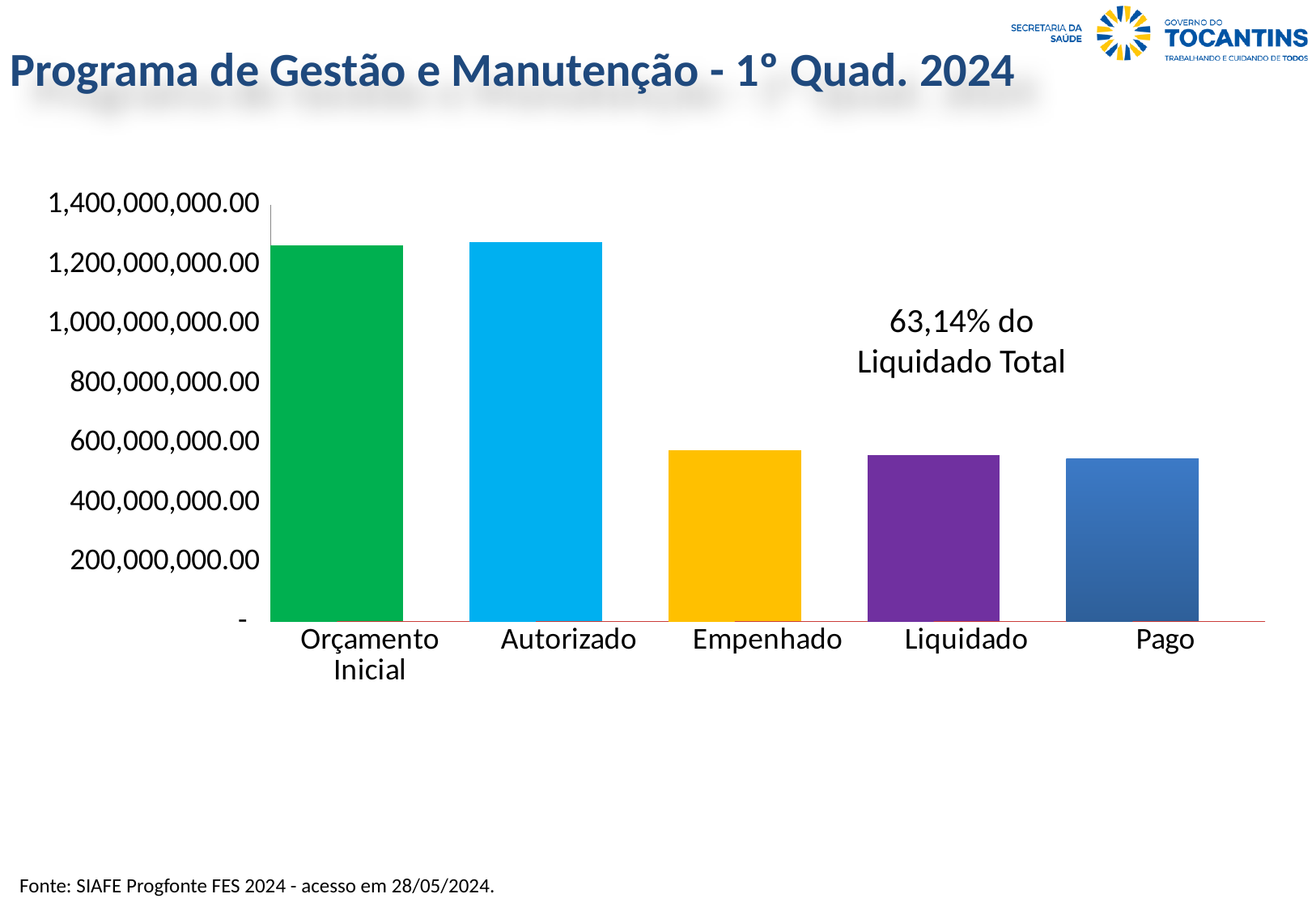
Which is larger, the value for Autorizado or the value for Empenhado? Autorizado Moving from Autorizado to Pago along the x axis, do the values rise or fall? fall Is the value for Empenhado greater or less than 600,000,000.00? less How many categories are shown on the x axis of the chart? 5 What kind of chart is shown on the slide? bar chart Is the value for Autorizado greater or less than 1,400,000,000.00? less Is the value for Pago greater or less than 400,000,000.00? greater What colour is the Empenhado bar? yellow Which is larger, the value for Orçamento Inicial or the value for Pago? Orçamento Inicial What percentage annotation is printed on the chart? 63,14% do Liquidado Total